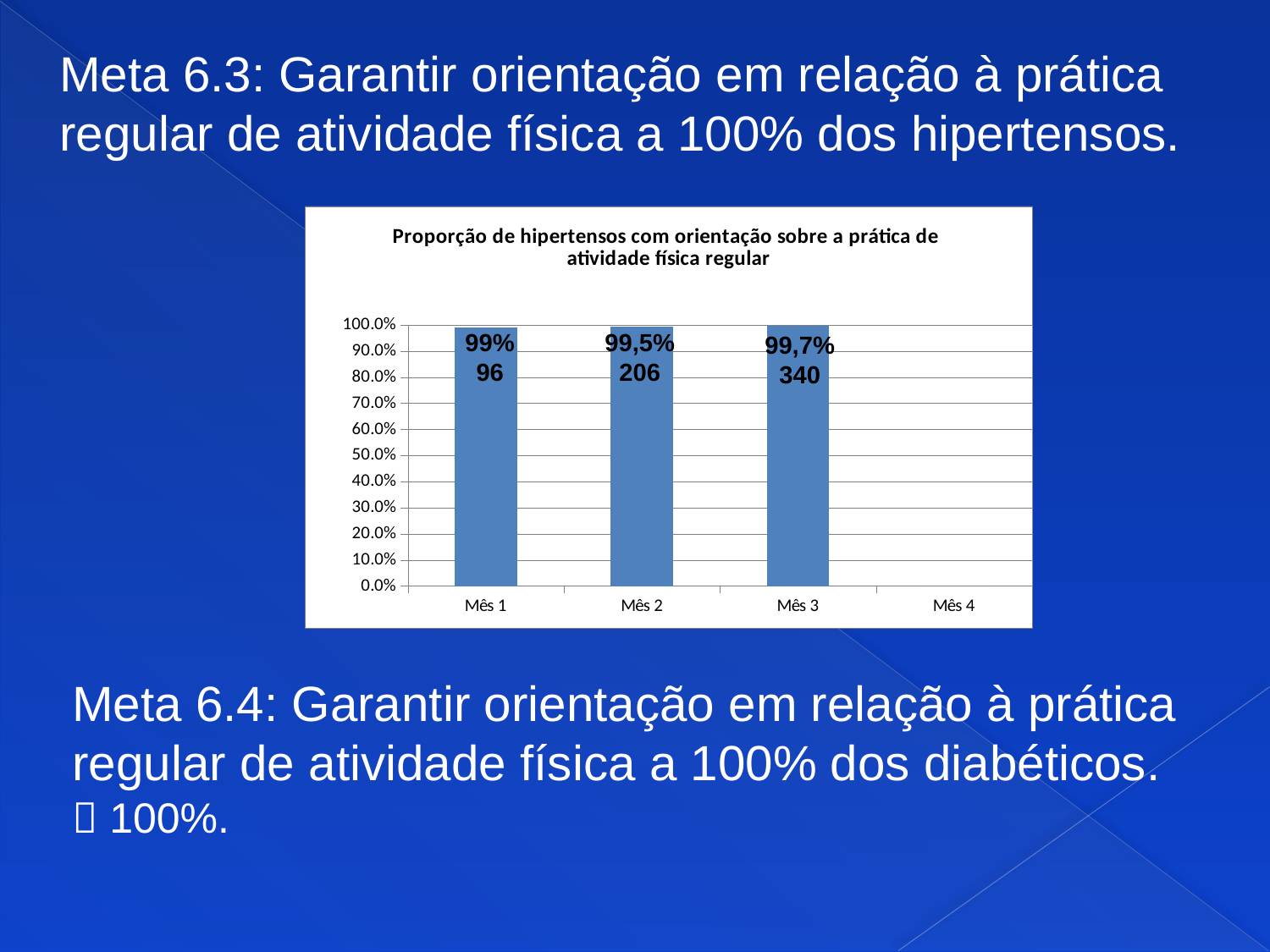
What is the difference between the counts printed for Mês 3 and Mês 2? 134 What type of chart is shown on the slide? Bar chart Which month category on the x axis has no bar plotted? Mês 4 Which month has the highest percentage according to the data labels? Mês 3 What percentage is shown for Mês 3? 99,7% What count is printed on the bar for Mês 2? 206 What percentage is shown for Mês 1? 99% What count is printed on the bar for Mês 3? 340 Which month with a bar has the lowest percentage according to the data labels? Mês 1 What percentage is shown for Mês 2? 99,5% Do the percentages rise or fall from Mês 1 to Mês 3? Rise How many month categories are shown on the x axis? 4